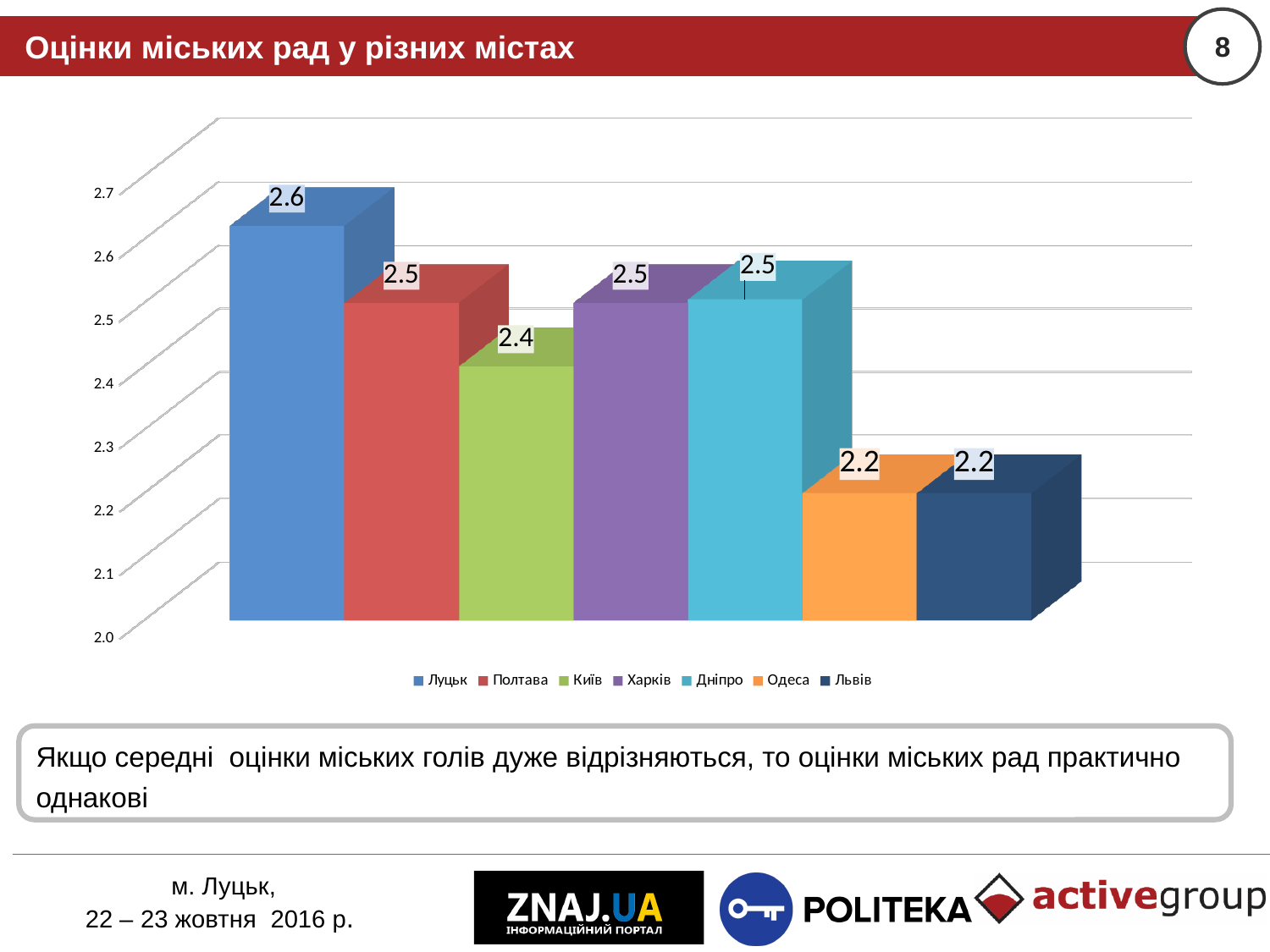
Which city has the highest value on the chart? Луцьк Is the value for Луцьк greater or less than 2.5? greater Which is larger, the value for Київ or the value for Одеса? Київ How many cities are shown on the chart? 7 What is the difference between the values for Луцьк and Львів? 0.4 What is the value shown for Одеса? 2.2 What is the value shown for Луцьк? 2.6 What is the difference between the values for Полтава and Київ? 0.1 What kind of chart is shown on the slide? Bar chart What is the title of the slide? Оцінки міських рад у різних містах What is the value shown for Харків? 2.5 What is the value shown for Київ? 2.4